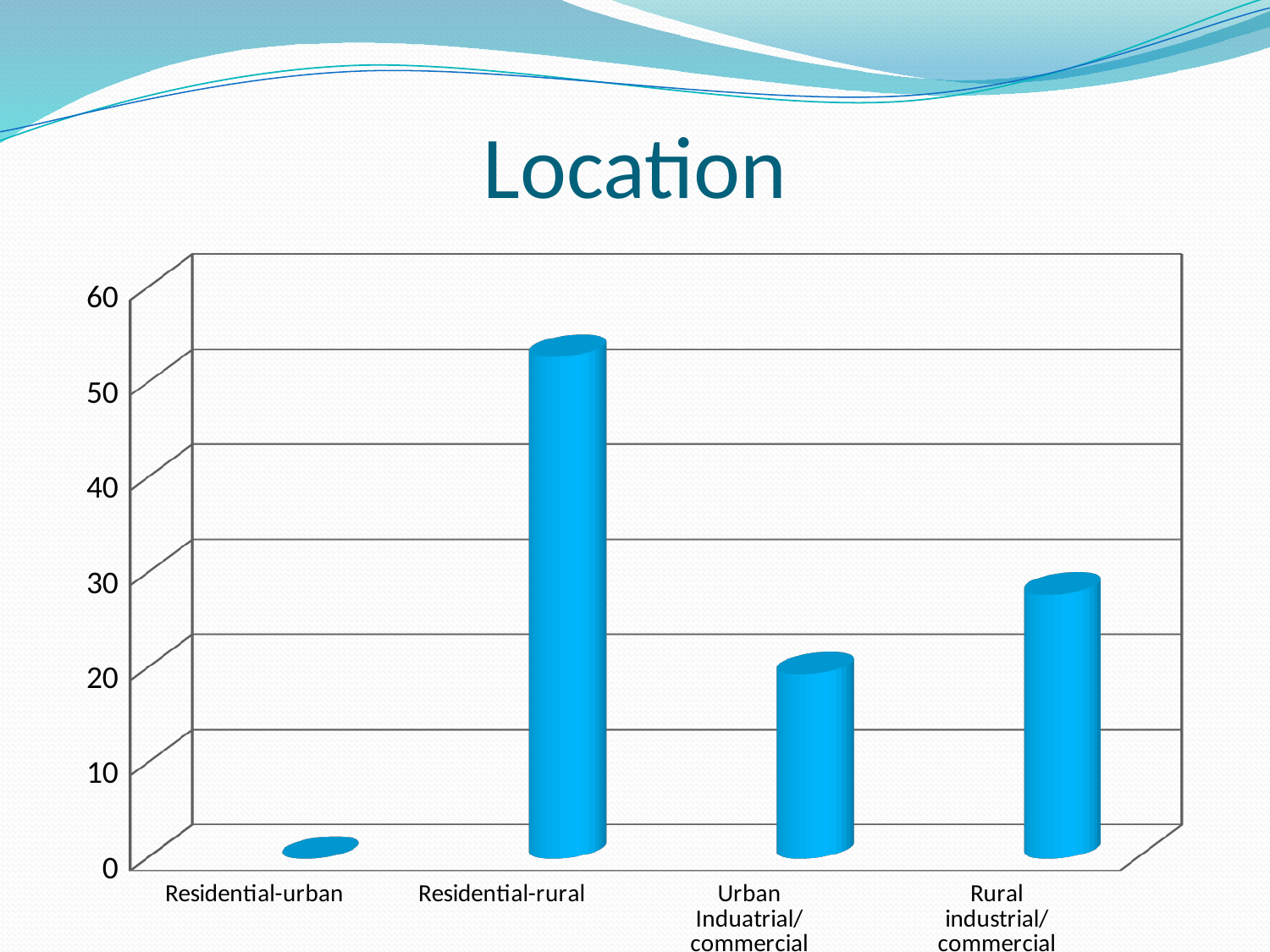
Which category has the highest value? Residential-rural Which category has the lowest value? Residential-urban Is the value for Urban Induatrial/commercial greater or less than 30? less What is the title of the chart? Location Which is larger, the value for Rural industrial/commercial or the value for Urban Induatrial/commercial? Rural industrial/commercial Is the value for Residential-urban greater or less than 10? less Which is larger, the value for Residential-rural or the value for Rural industrial/commercial? Residential-rural How many categories are shown on the x axis of the chart? 4 Is the value for Residential-rural greater or less than 40? greater What colour are the bars in the chart? blue What kind of chart is shown on the slide? bar chart